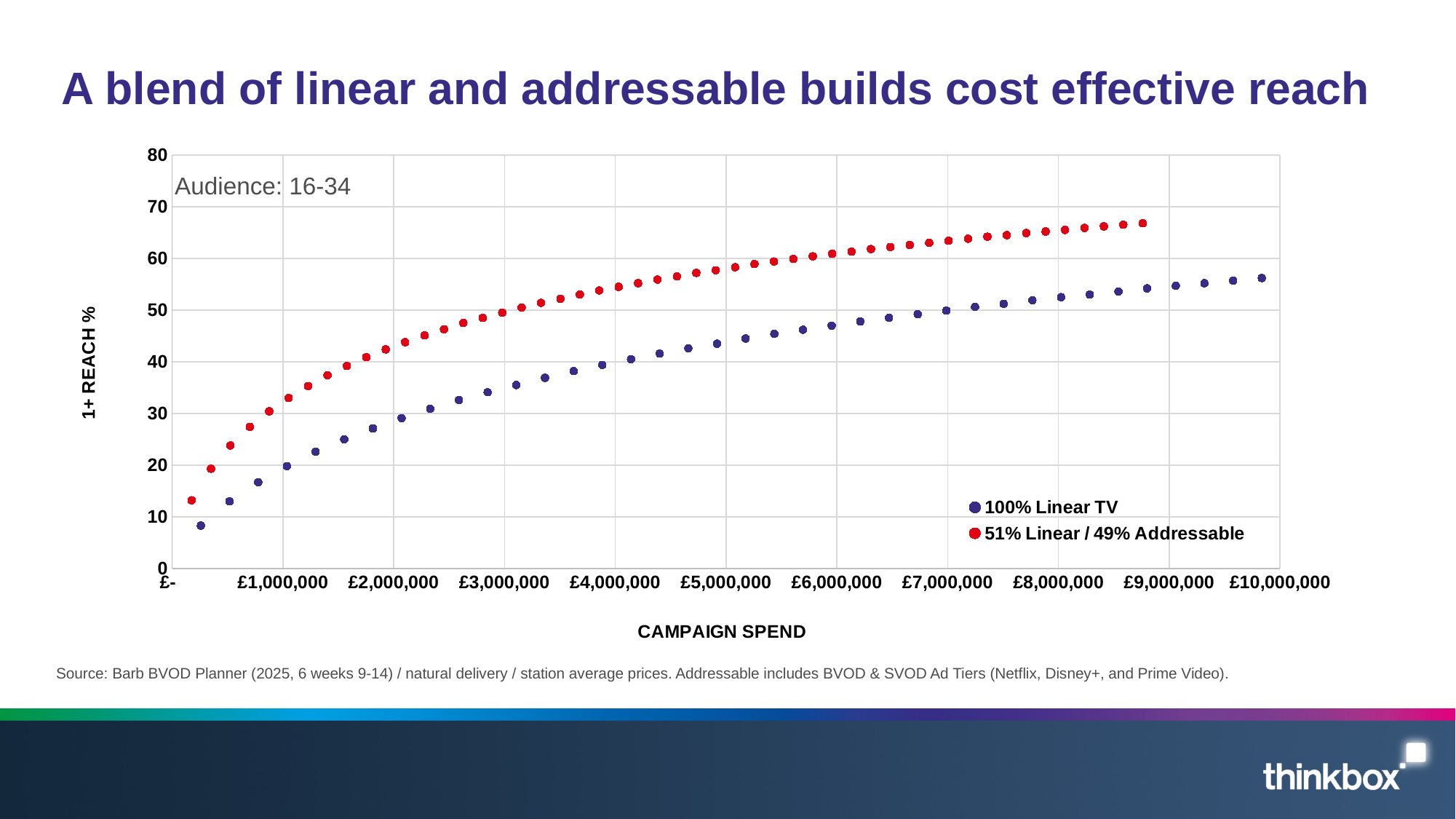
Is the 1+ reach % for 51% Linear / 49% Addressable at £8,000,000 campaign spend greater or less than 60? greater Does the 1+ reach % for 100% Linear TV rise or fall as campaign spend increases? Rise What are the two series named in the legend? 100% Linear TV; 51% Linear / 49% Addressable Does the 1+ reach % for 51% Linear / 49% Addressable rise or fall as campaign spend increases? Rise What is the title of the chart on the slide? A blend of linear and addressable builds cost effective reach Is the 1+ reach % for 100% Linear TV at £5,000,000 campaign spend greater or less than 40? greater Is the 1+ reach % for 100% Linear TV at £10,000,000 campaign spend greater or less than 60? less How many series does the legend list? 2 What kind of chart is shown on the slide? Scatter chart At £4,000,000 campaign spend, which series has the higher 1+ reach %: 100% Linear TV or 51% Linear / 49% Addressable? 51% Linear / 49% Addressable